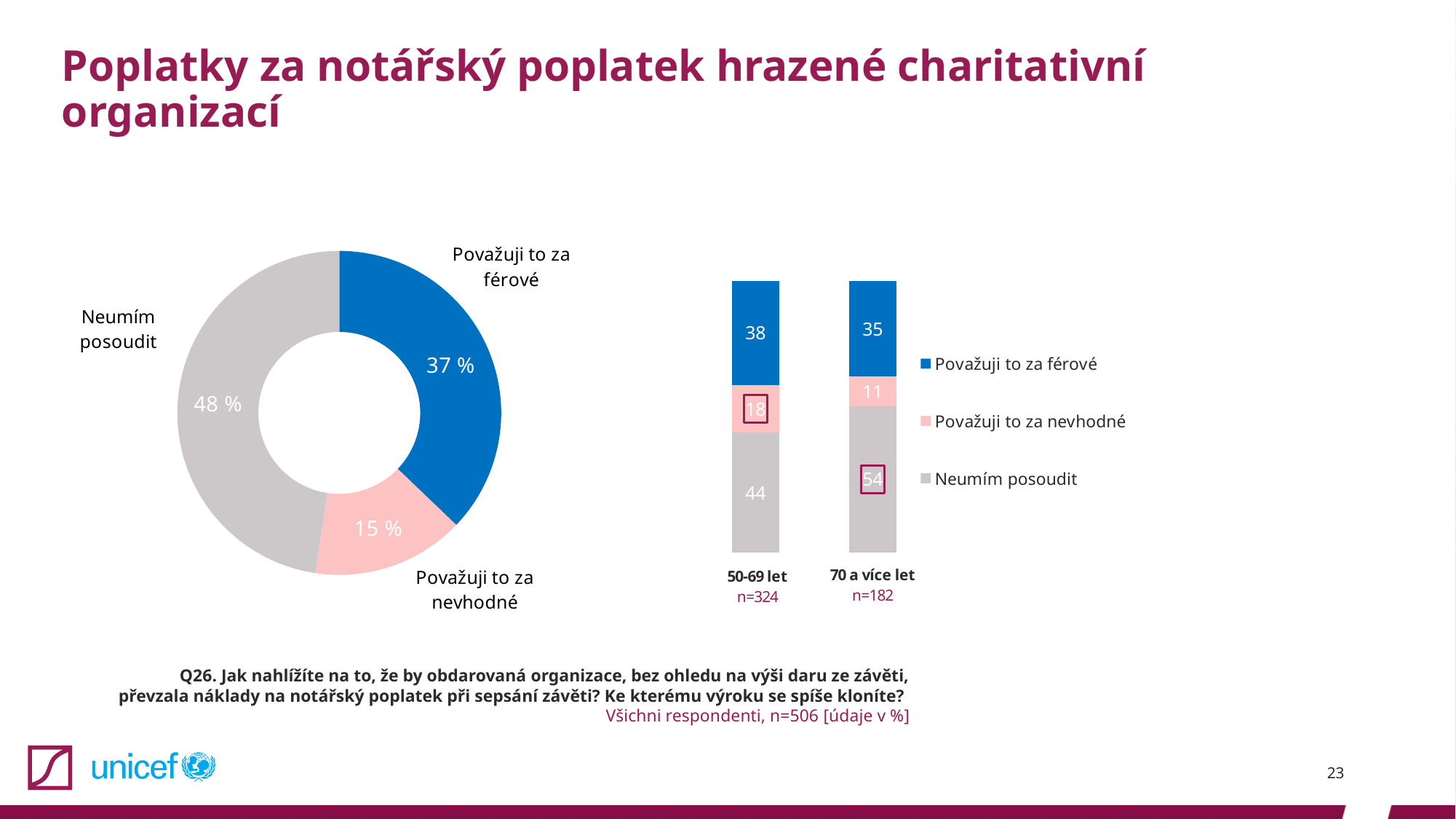
In the donut chart on the left, which category has the smallest share? Považuji to za nevhodné In the donut chart on the left, what share is labelled for "Považuji to za férové"? 37 % In the donut chart on the left, what is the difference between the shares for "Neumím posoudit" and "Považuji to za férové"? 11 % In the stacked bar chart on the right, what is the value for "Považuji to za nevhodné" in the "50-69 let" group? 18 In the stacked bar chart on the right, which group has the higher value for "Považuji to za férové": "50-69 let" or "70 a více let"? 50-69 let What type of chart is shown on the left of the slide? Donut chart In the stacked bar chart on the right, what is the sample size (n) shown for the "70 a více let" group? n=182 In the stacked bar chart on the right, what is the difference between the "Neumím posoudit" values for "70 a více let" and "50-69 let"? 10 How many age groups are shown in the stacked bar chart on the right? 2 In the donut chart on the left, which category has the largest share? Neumím posoudit How many series does the legend of the stacked bar chart on the right list? 3 In the stacked bar chart on the right, what is the value for "Neumím posoudit" in the "70 a více let" group? 54